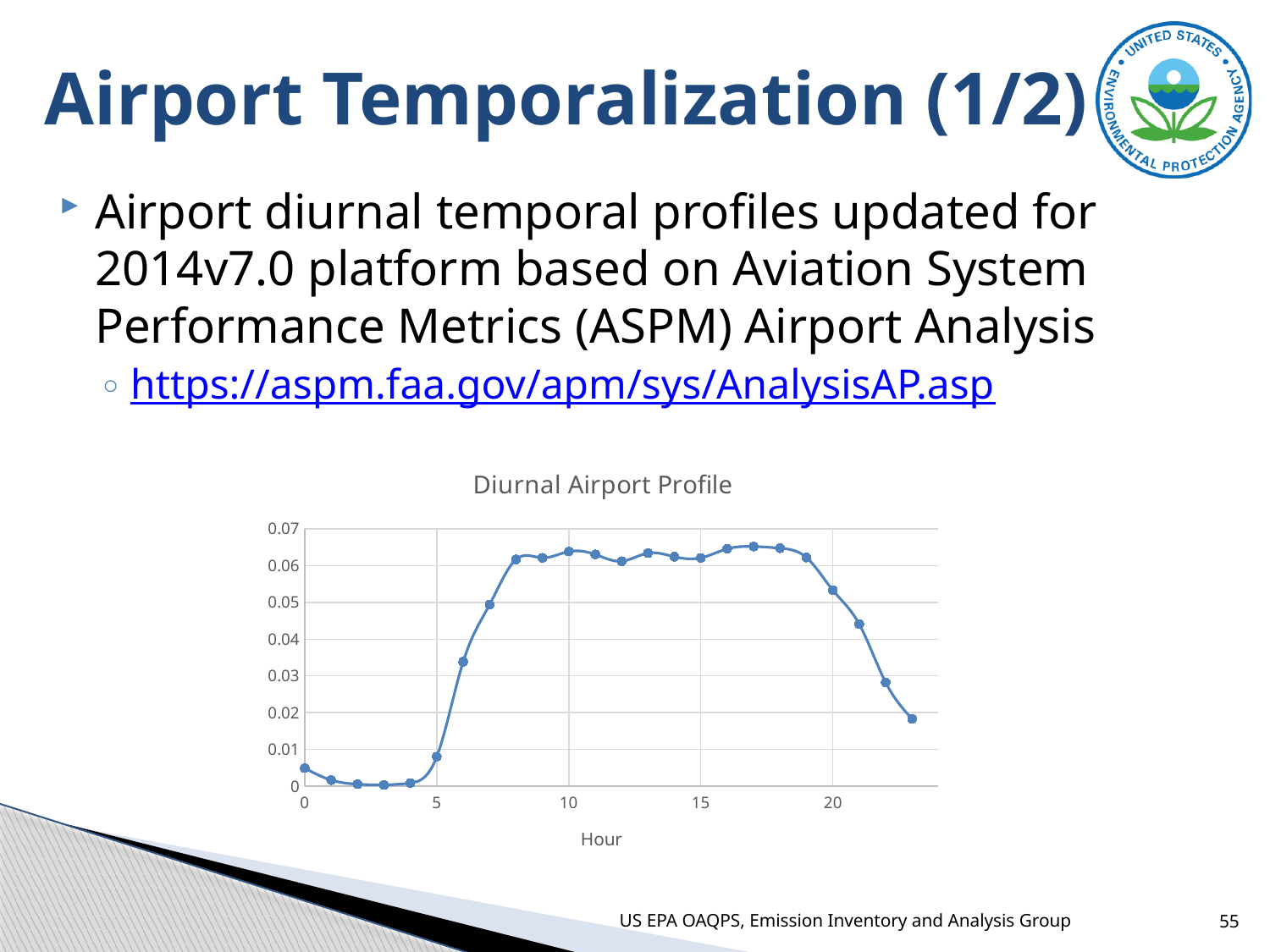
Do the values rise or fall between hour 19 and hour 23? fall What is the label of the x axis of the chart? Hour Is the value at hour 21 greater or less than 0.05? less What is the title of the chart? Diurnal Airport Profile What kind of chart is the Diurnal Airport Profile? line chart Is the value at hour 17 greater or less than 0.06? greater Is the value at hour 7 greater or less than 0.04? greater How many data points are plotted on the Diurnal Airport Profile line? 24 Which is larger, the value at hour 10 or the value at hour 5? hour 10